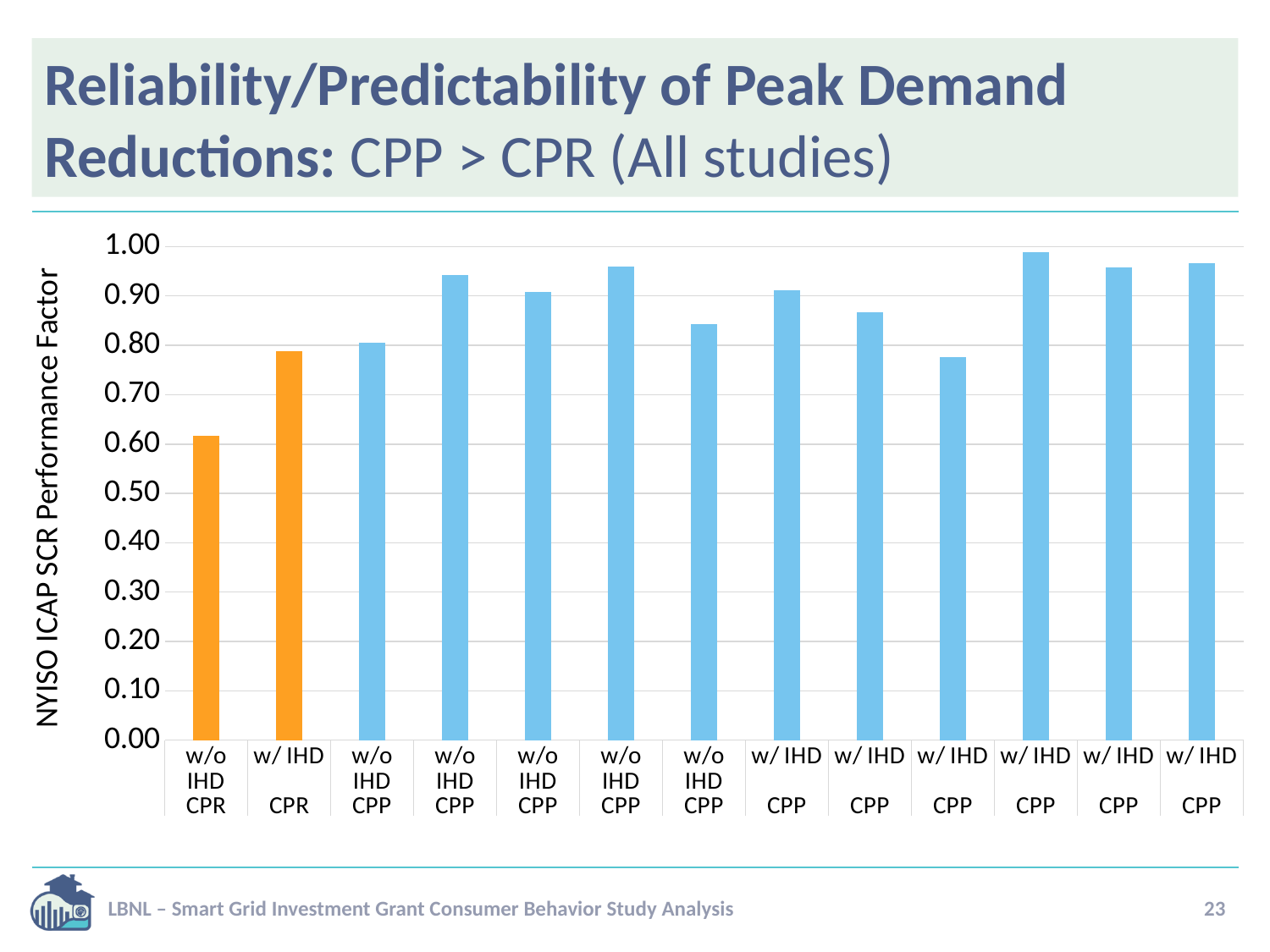
What colour are the CPR bars in the chart? orange Which bar has the lowest NYISO ICAP SCR Performance Factor? w/o IHD CPR Which is larger, the value for w/o IHD CPR or the value for w/ IHD CPR? w/ IHD CPR Is the value of the fourth bar from the left (the second w/o IHD CPP bar) greater or less than 0.90? greater Is the value for w/ IHD CPR greater or less than 0.70? greater How many bars are plotted in the chart? 13 Is the value of the tenth bar from the left (the third w/ IHD CPP bar) greater or less than 0.90? less What kind of chart is shown on the slide? bar chart What is the label on the vertical axis of the chart? NYISO ICAP SCR Performance Factor How many bars in the chart are labelled CPP? 11 How many bars in the chart are labelled CPR? 2